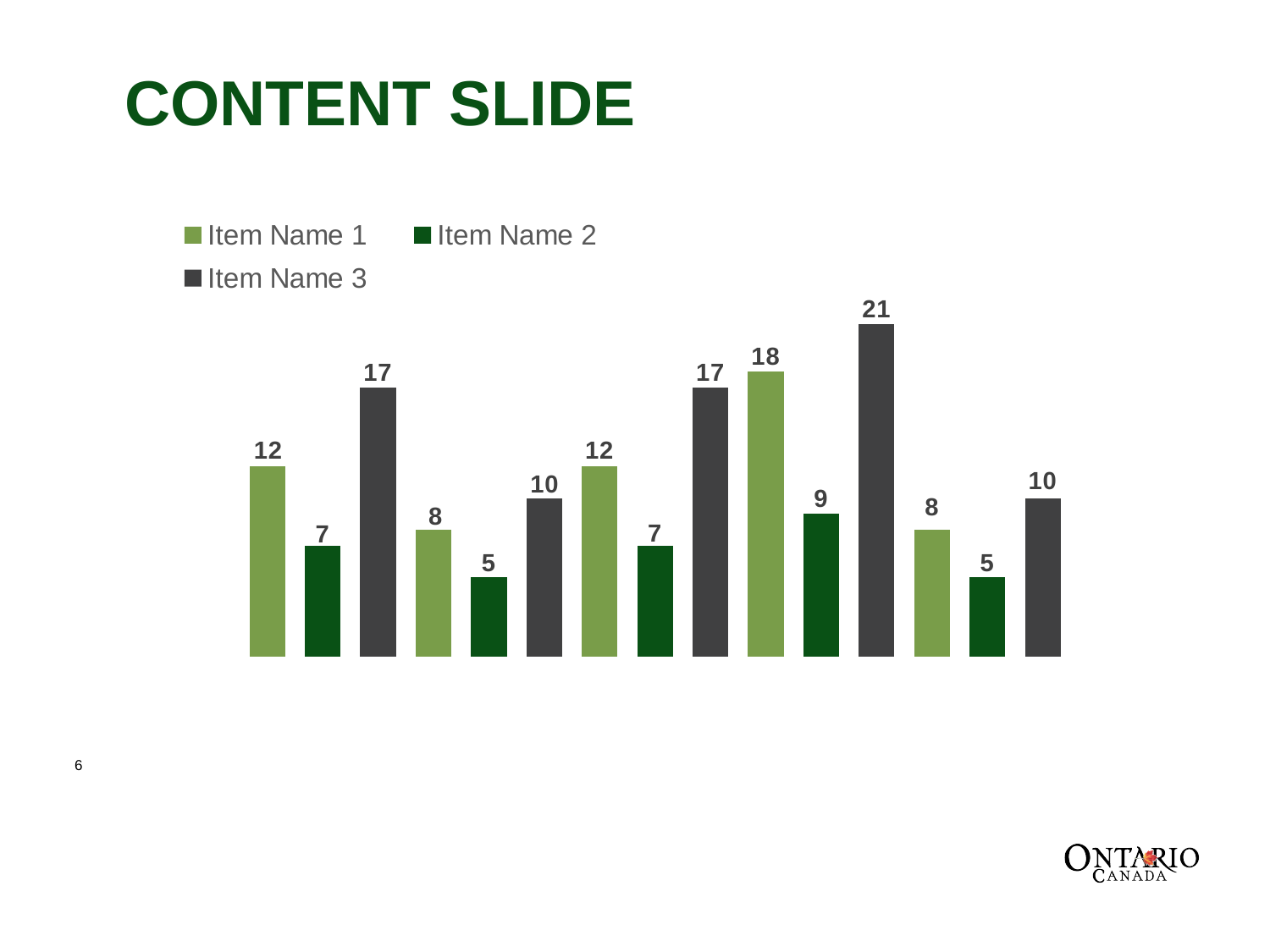
In the fourth group of bars from the left, what is the difference between Item Name 1 and Item Name 2? 9 What colour represents Item Name 2 in the legend? dark green What is the highest value for Item Name 1 across all groups? 18 How many series does the legend list? 3 What is the highest value shown in the chart? 21 What kind of chart is shown on the slide? bar chart Which is larger: Item Name 1 in the first group of bars or Item Name 3 in the second group of bars? Item Name 1 in the first group How many groups of bars are plotted in the chart? 5 What is the lowest value shown in the chart? 5 What is the value of Item Name 1 in the second group of bars from the left? 8 What is the value of Item Name 2 in the third group of bars from the left? 7 What is the value of Item Name 3 in the fourth group of bars from the left? 21